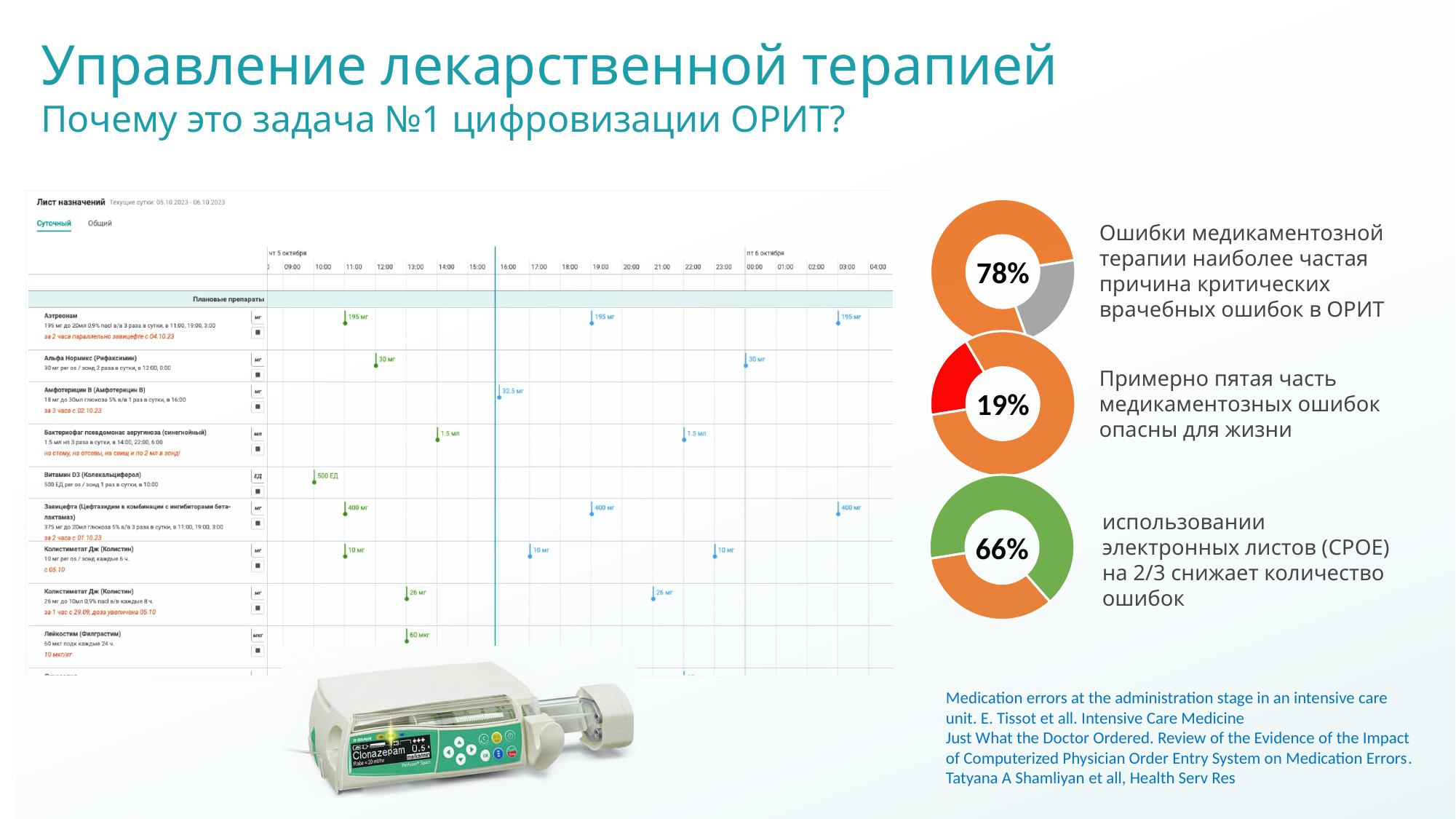
Which of the three donut charts shows the highest percentage? The top one (78%) What percentage is shown in the centre of the bottom donut chart on the right side of the slide? 66% What percentage is shown in the centre of the middle donut chart on the right side of the slide? 19% How many donut charts are shown on the right side of the slide? 3 Which is larger: the percentage in the middle donut chart or the percentage in the bottom donut chart? The bottom donut chart (66%) What share of the top donut chart does the orange slice represent? 78% What colour is the highlighted slice in the middle donut chart (the 19% slice)? Red What kind of charts are the three charts on the right side of the slide? Donut (pie) charts What is the difference between the percentage in the top donut chart and the percentage in the bottom donut chart? 12% Which of the three donut charts shows the lowest percentage? The middle one (19%) What percentage is shown in the centre of the top donut chart on the right side of the slide? 78% What colour is the large slice in the bottom donut chart (the 66% slice)? Green